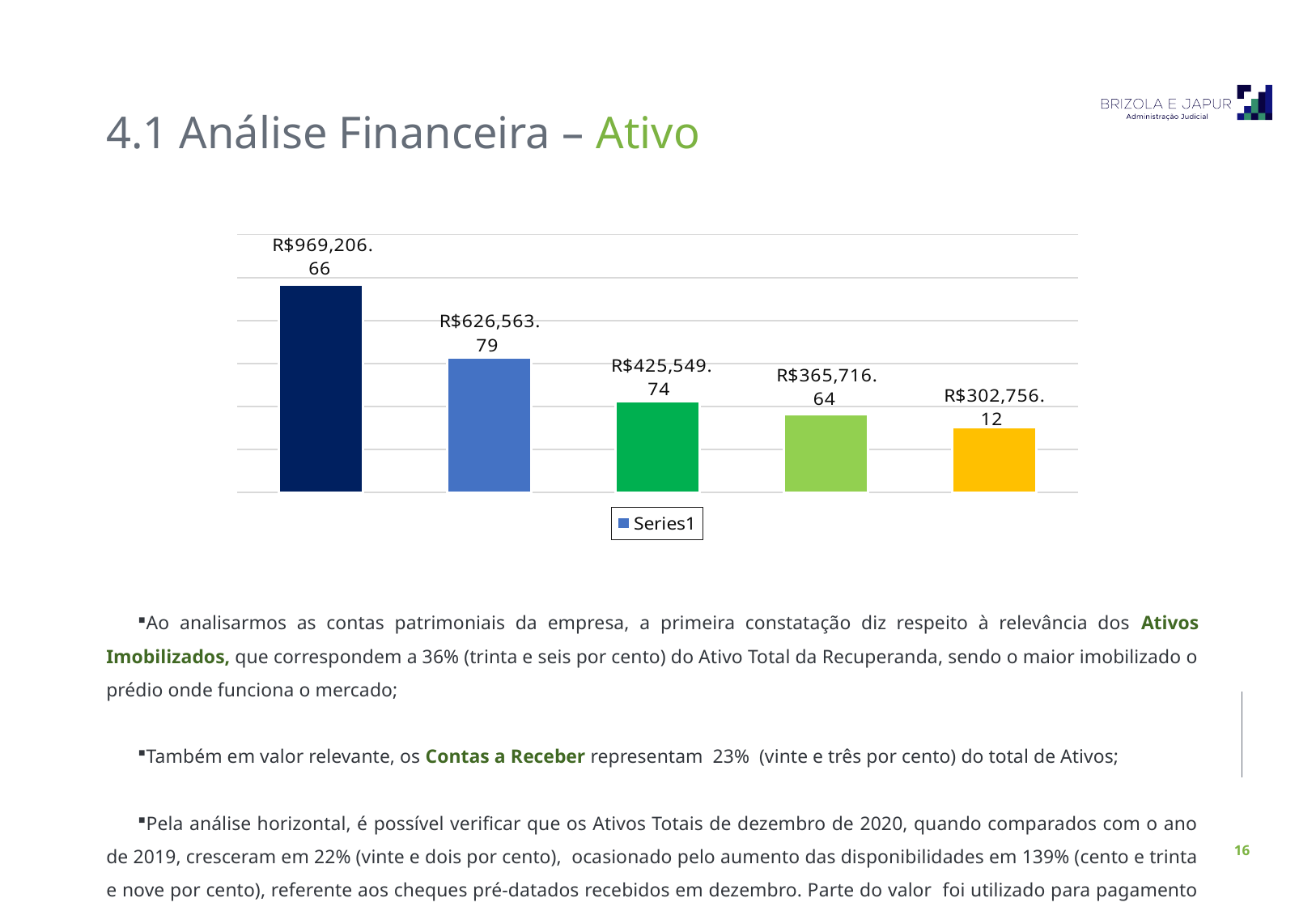
What kind of chart is shown on the slide? Bar chart What value is printed on the last (yellow) bar of the chart? R$302,756.12 What value is printed on the second (blue) bar of the chart? R$626,563.79 Which is larger, the second bar or the third bar? The second bar (R$626,563.79) What is the highest value shown in the chart? R$969,206.66 What is the lowest value shown in the chart? R$302,756.12 What value is printed on the third (green) bar of the chart? R$425,549.74 What value is printed on the first (dark blue) bar of the chart? R$969,206.66 What is the difference between the first bar (R$969,206.66) and the last bar (R$302,756.12)? R$666,450.54 How many bars are plotted in the chart? 5 Do the bar values rise or fall from left to right? Fall What value is printed on the fourth (light green) bar of the chart? R$365,716.64